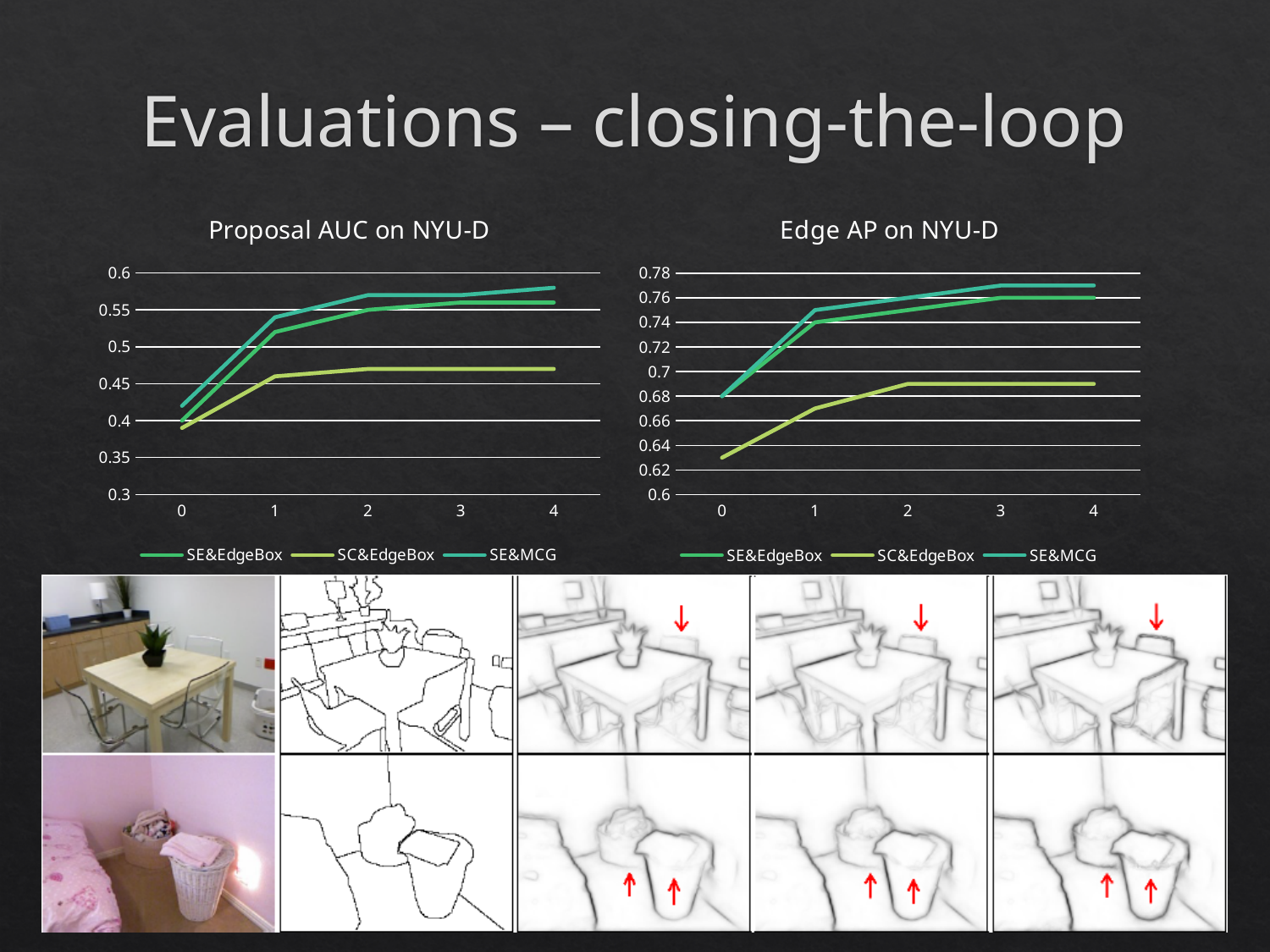
Which series is listed first in the legend of the "Proposal AUC on NYU-D" chart? SE&EdgeBox How many x-axis points are plotted in the "Proposal AUC on NYU-D" chart? 5 In the "Edge AP on NYU-D" chart, is the value of SC&EdgeBox at x = 0 greater or less than 0.66? less In the "Proposal AUC on NYU-D" chart, is the value of SE&MCG at x = 4 greater or less than 0.55? greater In the "Edge AP on NYU-D" chart, which series has the lowest value at x = 4? SC&EdgeBox What kind of chart is the "Proposal AUC on NYU-D" chart? line chart In the "Proposal AUC on NYU-D" chart, which is larger at x = 2: SE&EdgeBox or SC&EdgeBox? SE&EdgeBox In the "Proposal AUC on NYU-D" chart, which series has the highest value at x = 4? SE&MCG In the "Edge AP on NYU-D" chart, is the value of SC&EdgeBox at x = 4 greater or less than 0.7? less How many series does the legend of the "Edge AP on NYU-D" chart list? 3 What is the title of the chart on the right side of the slide? Edge AP on NYU-D In the "Proposal AUC on NYU-D" chart, does the SC&EdgeBox series rise or fall from x = 0 to x = 2? rise